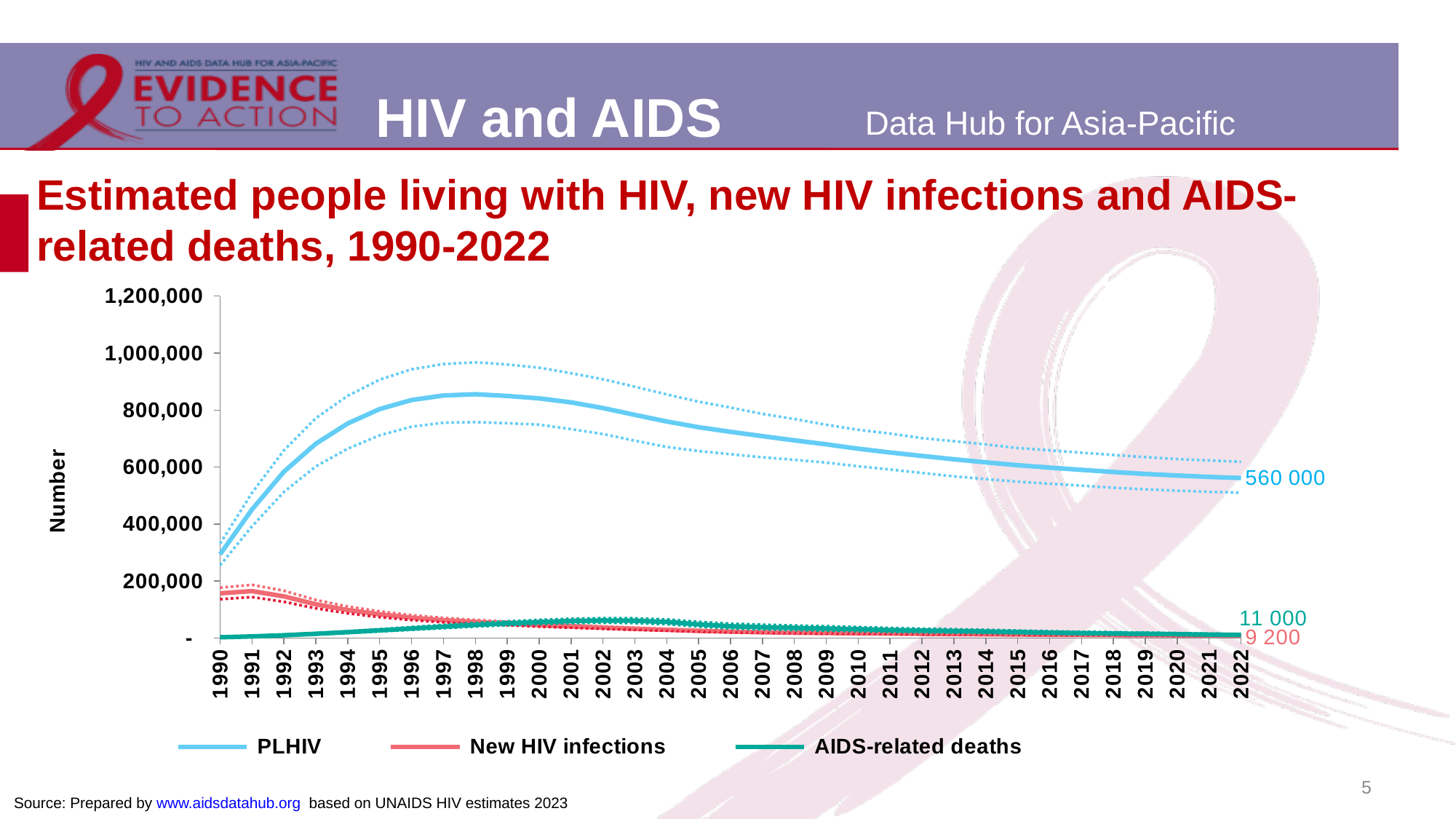
What is the difference between PLHIV and AIDS-related deaths in 2022? 549 000 What is the difference between AIDS-related deaths and New HIV infections in 2022? 1 800 What is the value for AIDS-related deaths in 2022? 11 000 Is the value for PLHIV in 1990 greater or less than 400,000? less In 2022, which is larger: AIDS-related deaths or New HIV infections? AIDS-related deaths Is the value for PLHIV in 1998 greater or less than 800,000? greater What is the value for PLHIV in 2022? 560 000 Which series has the highest value in 2022? PLHIV Does the PLHIV line rise or fall from 1998 to 2022? fall What kind of chart is shown on the slide? line chart What is the value for New HIV infections in 2022? 9 200 How many series does the legend list? 3